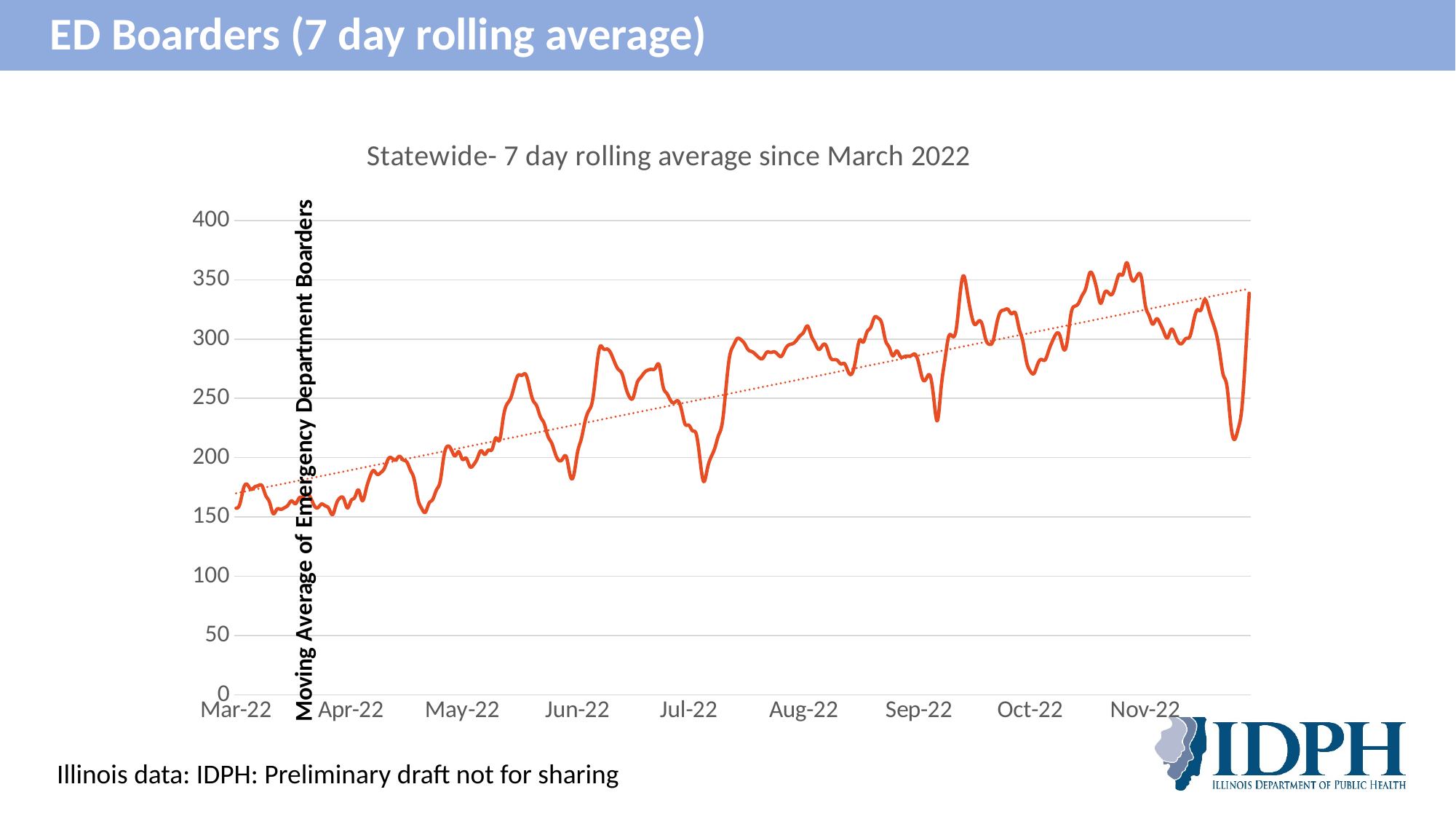
Which is larger, the value at Aug-22 or the value at Apr-22? Aug-22 What is the title of the chart? Statewide- 7 day rolling average since March 2022 What is the highest value shown on the vertical axis? 400 Is the value at the start of Mar-22 greater or less than 200? less What is the label on the vertical axis of the chart? Moving Average of Emergency Department Boarders Is the value at Sep-22 greater or less than 250? greater Is the value at Aug-22 greater or less than 250? greater How many month labels are shown on the x axis? 9 Overall, do the values rise or fall from Mar-22 to Nov-22? rise What kind of chart is shown on the slide? line chart